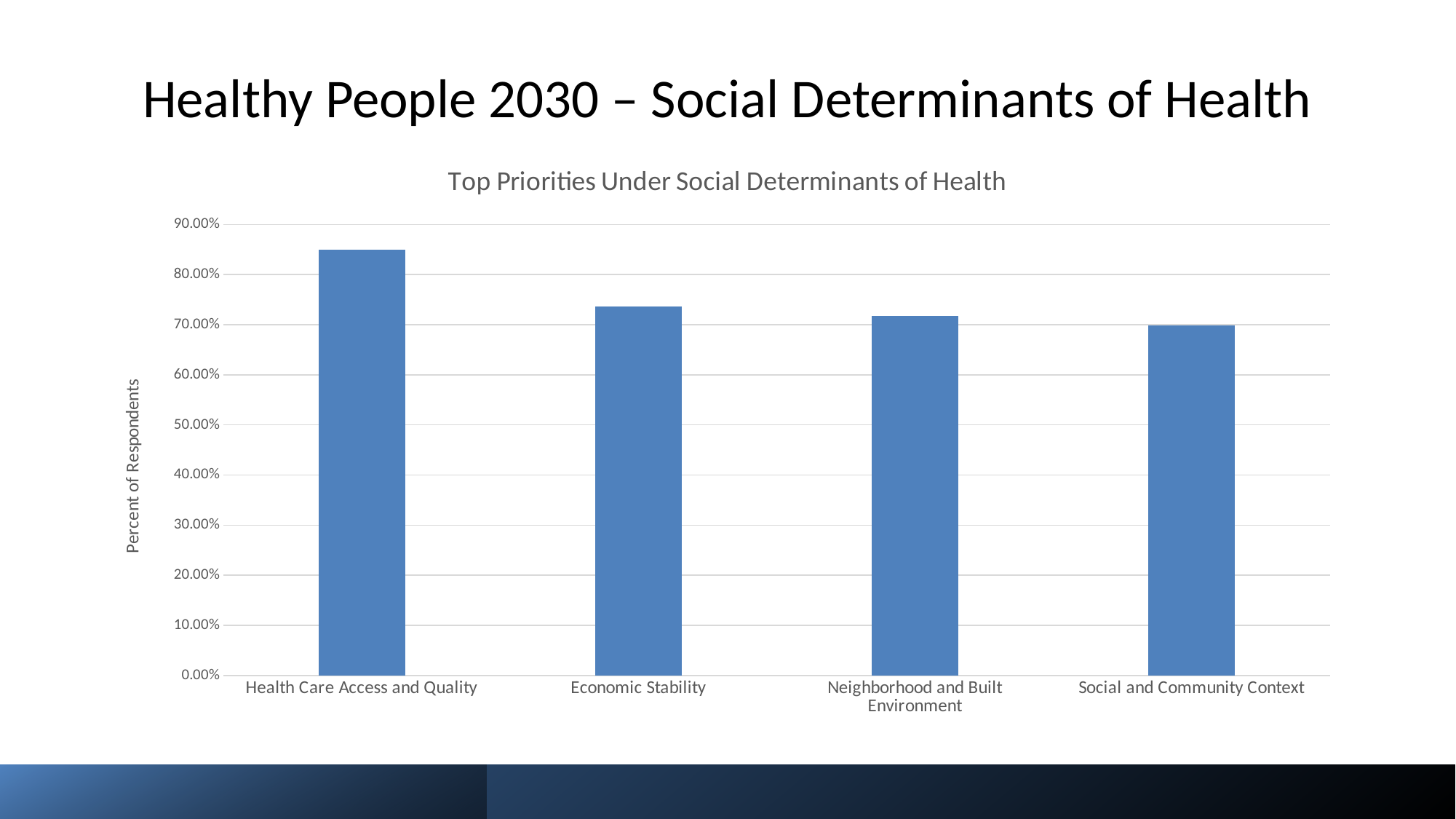
Is the value for Neighborhood and Built Environment greater or less than 80.00%? less Which is larger, the value for Economic Stability or the value for Social and Community Context? Economic Stability Is the value for Health Care Access and Quality greater or less than 80.00%? greater What kind of chart is shown on the slide? Bar chart What is the title of the chart? Top Priorities Under Social Determinants of Health Do the values rise or fall moving from left to right along the x axis? Fall Is the value for Social and Community Context greater or less than 60.00%? greater Which category has the lowest percent of respondents? Social and Community Context Which is larger, the value for Health Care Access and Quality or the value for Economic Stability? Health Care Access and Quality How many categories are shown on the x axis of the chart? 4 Which category has the highest percent of respondents? Health Care Access and Quality